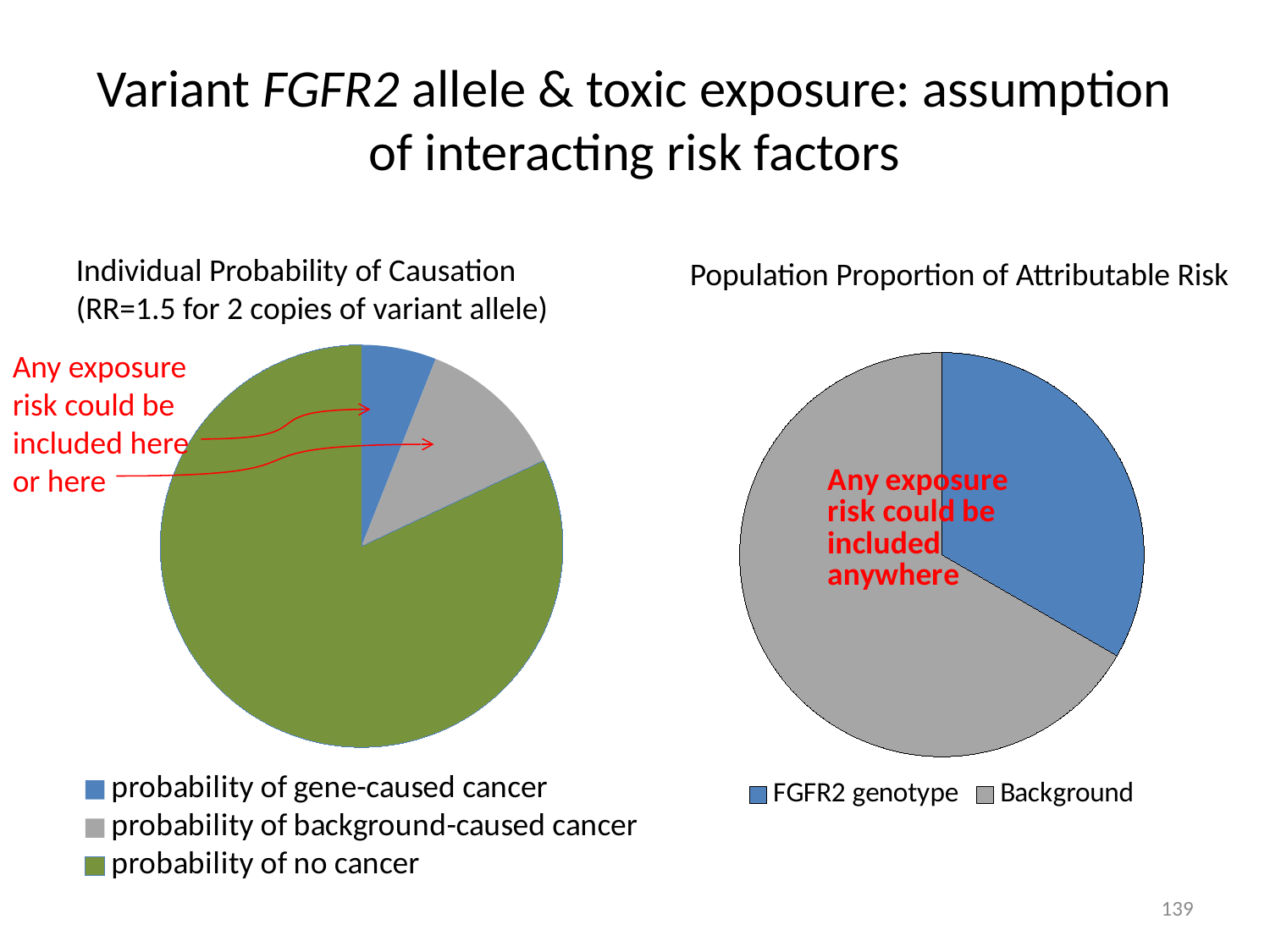
In the left chart 'Individual Probability of Causation', how many slices does the pie have? 3 In the right chart 'Population Proportion of Attributable Risk', which is larger: the Background slice or the FGFR2 genotype slice? Background What kind of chart is the right chart titled 'Population Proportion of Attributable Risk'? pie chart In the right chart 'Population Proportion of Attributable Risk', how many slices does the pie have? 2 What kind of chart is the left chart titled 'Individual Probability of Causation'? pie chart In the right chart 'Population Proportion of Attributable Risk', which slice is the smallest? FGFR2 genotype In the right chart 'Population Proportion of Attributable Risk', what are the two legend entries? FGFR2 genotype and Background In the left chart 'Individual Probability of Causation', which slice is the largest? probability of no cancer In the right chart 'Population Proportion of Attributable Risk', which slice is the largest? Background In the left chart 'Individual Probability of Causation', what colour is the slice for probability of no cancer? green In the left chart 'Individual Probability of Causation', which is larger: the slice for probability of background-caused cancer or the slice for probability of gene-caused cancer? probability of background-caused cancer In the left chart 'Individual Probability of Causation', which slice is the smallest? probability of gene-caused cancer